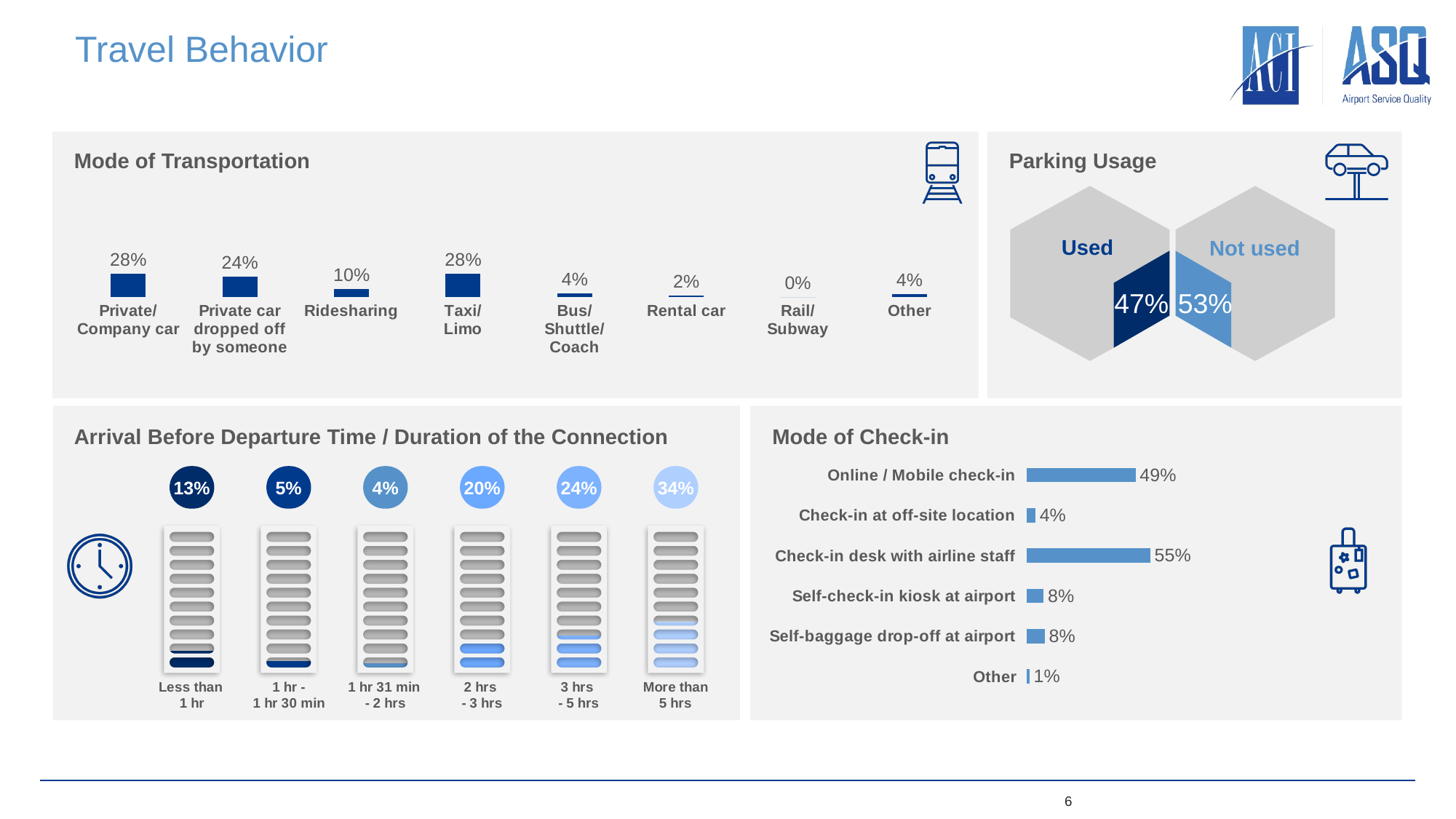
In the Arrival Before Departure Time / Duration of the Connection chart, which category has the highest percentage? More than 5 hrs In the Mode of Check-in chart, what percentage is shown for Online / Mobile check-in? 49% In the Arrival Before Departure Time / Duration of the Connection chart, what percentage is shown for 2 hrs - 3 hrs? 20% In the Parking Usage chart, which is larger, Used or Not used? Not used In the Mode of Transportation chart, which mode has the lowest percentage? Rail/Subway In the Mode of Transportation chart, how many modes of transportation are shown? 8 In the Parking Usage chart, what percentage is shown for Not used? 53% In the Arrival Before Departure Time / Duration of the Connection chart, which category has the lowest percentage? 1 hr 31 min - 2 hrs In the Mode of Transportation chart, what is the difference between Private/Company car and Private car dropped off by someone? 4% What kind of chart is the Mode of Check-in chart? Bar chart In the Mode of Transportation chart, what percentage is shown for Ridesharing? 10% In the Mode of Check-in chart, which category has the highest percentage? Check-in desk with airline staff